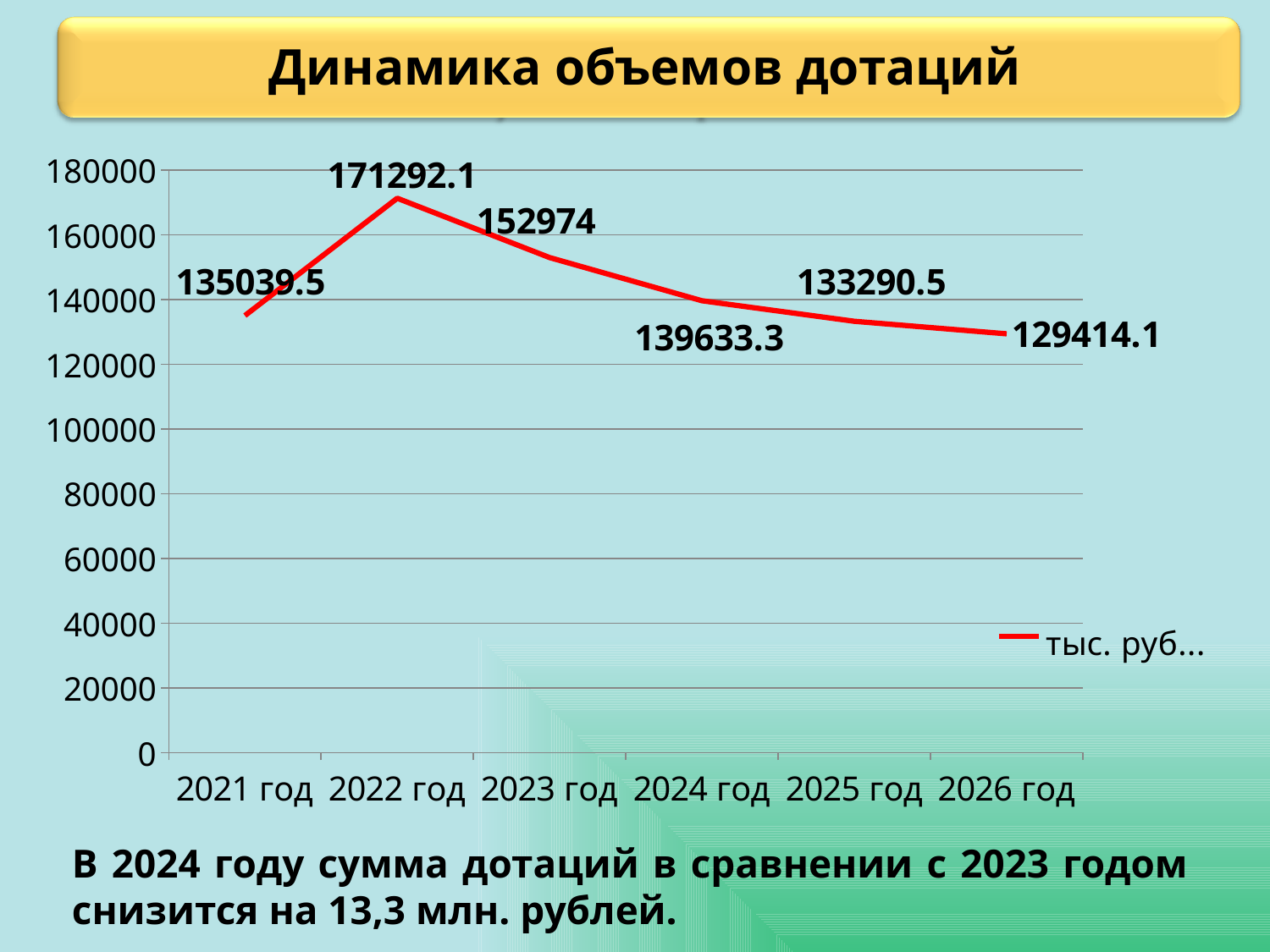
How many years are plotted on the chart? 6 What is the title of the chart? Динамика объемов дотаций What type of chart is shown on the slide? line chart What is the difference between the values for 2022 год and 2021 год? 36252.6 Which is larger, the value for 2021 год or the value for 2025 год? 2021 год What is the value for 2024 год? 139633.3 What is the value for 2026 год? 129414.1 Which year has the highest value? 2022 год What is the difference between the values for 2023 год and 2024 год? 13340.7 What is the value for 2022 год? 171292.1 Which year has the lowest value? 2026 год Do the values rise or fall from 2022 год to 2026 год? fall